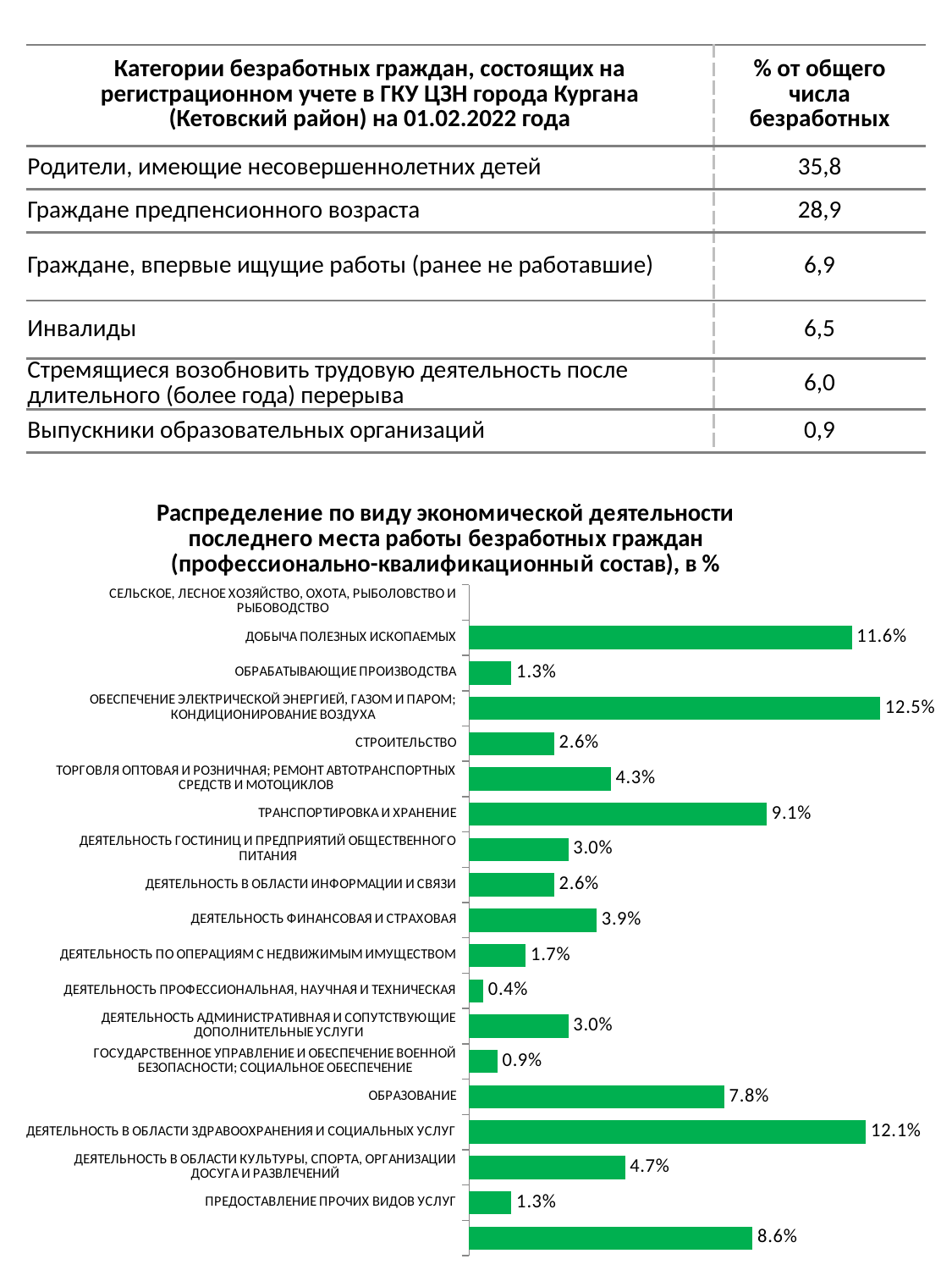
In the bar chart, which labelled category has the lowest non-zero value? Деятельность профессиональная, научная и техническая In the bar chart, which category has the highest value? Обеспечение электрической энергией, газом и паром; кондиционирование воздуха In the bar chart, what is the value for 'Добыча полезных ископаемых'? 11.6% In the bar chart, what is the value for 'Транспортировка и хранение'? 9.1% In the bar chart, which is larger: the value for 'Образование' or for 'Транспортировка и хранение'? Транспортировка и хранение In the bar chart, what is the value for 'Государственное управление и обеспечение военной безопасности; социальное обеспечение'? 0.9% In the bar chart, what is the difference between the values for 'Обеспечение электрической энергией, газом и паром; кондиционирование воздуха' and 'Деятельность в области здравоохранения и социальных услуг'? 0.4% In the bar chart, what is the value for 'Деятельность финансовая и страховая'? 3.9% What kind of chart is shown under the title 'Распределение по виду экономической деятельности последнего места работы безработных граждан'? bar chart In the bar chart, what is the value for 'Образование'? 7.8% What colour are the bars in the bar chart? green In the bar chart, what is the value for 'Деятельность в области здравоохранения и социальных услуг'? 12.1%